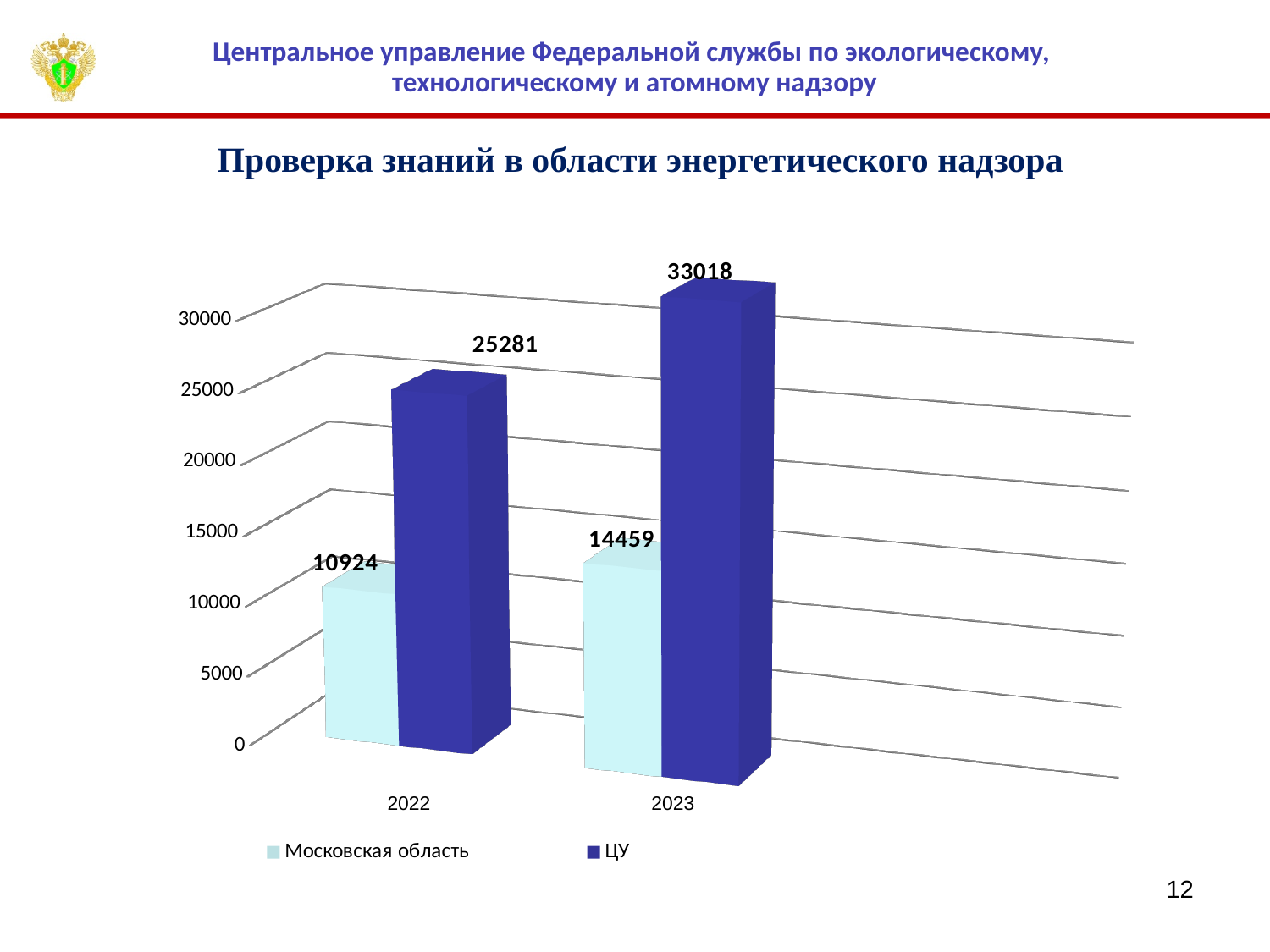
What is the value for Московская область in 2022? 10924 What is the difference between the ЦУ and Московская область values in 2023? 18559 Do the values for Московская область rise or fall from 2022 to 2023? rise What is the value for ЦУ in 2023? 33018 How many series does the legend list? 2 Which year has the lowest value for Московская область? 2022 What is the value for Московская область in 2023? 14459 What kind of chart is shown on the slide? bar chart Which is larger in 2022: Московская область or ЦУ? ЦУ What is the value for ЦУ in 2022? 25281 Which year has the highest value for ЦУ? 2023 What is the difference between the ЦУ values for 2023 and 2022? 7737